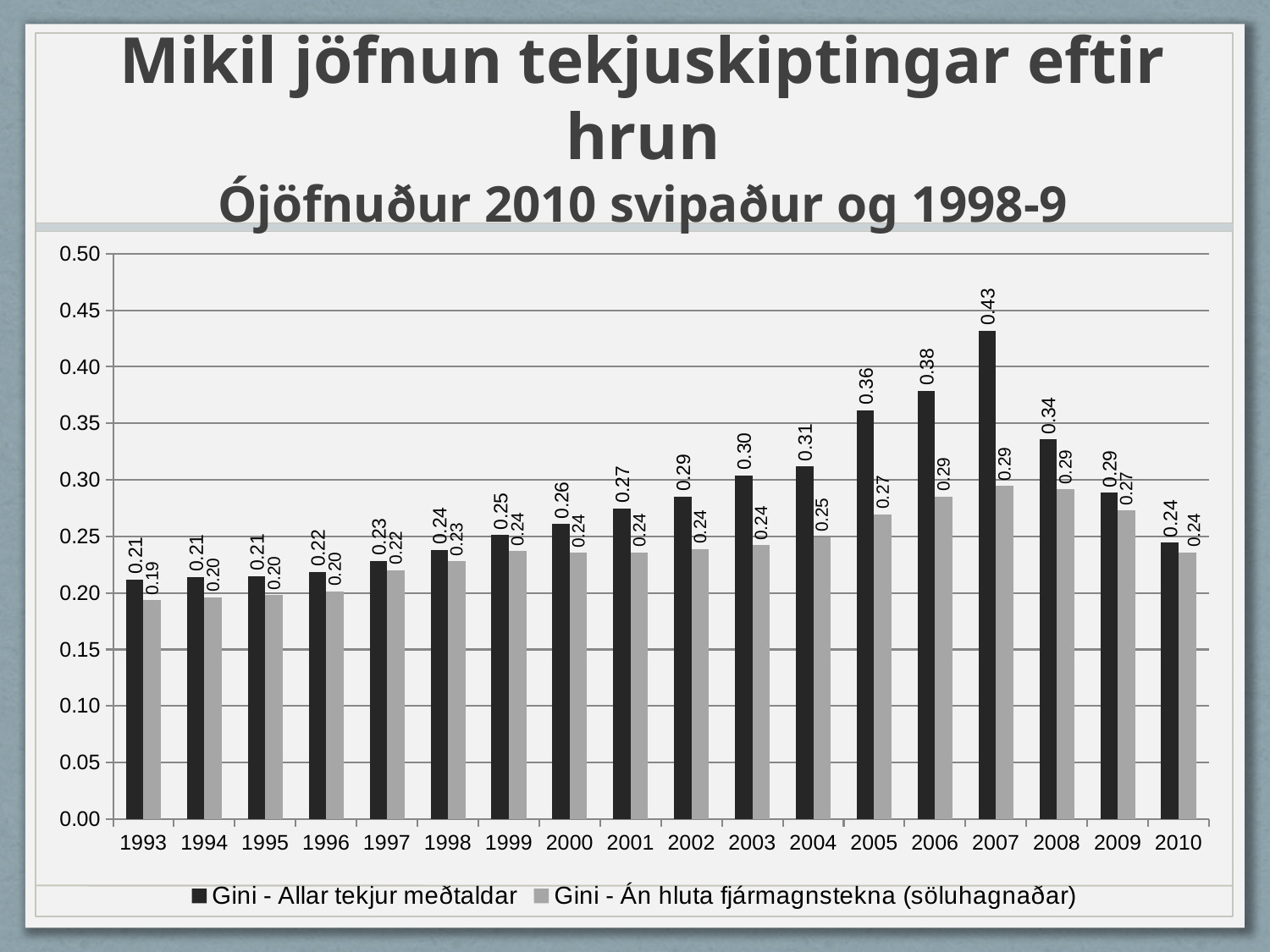
What is the value of "Gini - Allar tekjur meðtaldar" for 2007? 0.43 How many years are shown on the x axis? 18 Is the value for "Gini - Allar tekjur meðtaldar" in 2005 greater or less than 0.35? greater Does "Gini - Allar tekjur meðtaldar" rise or fall from 2007 to 2010? Fall What is the value of "Gini - Án hluta fjármagnstekna (söluhagnaðar)" for 2005? 0.27 What kind of chart is shown on the slide? Bar chart What is the value of "Gini - Allar tekjur meðtaldar" for 2010? 0.24 Which is larger: "Gini - Allar tekjur meðtaldar" in 2006 or in 2008? 2006 Which year has the lowest value for "Gini - Án hluta fjármagnstekna (söluhagnaðar)"? 1993 Which year has the highest value for "Gini - Allar tekjur meðtaldar"? 2007 What is the difference between the two series' values in 2007? 0.14 How many series does the legend list? 2